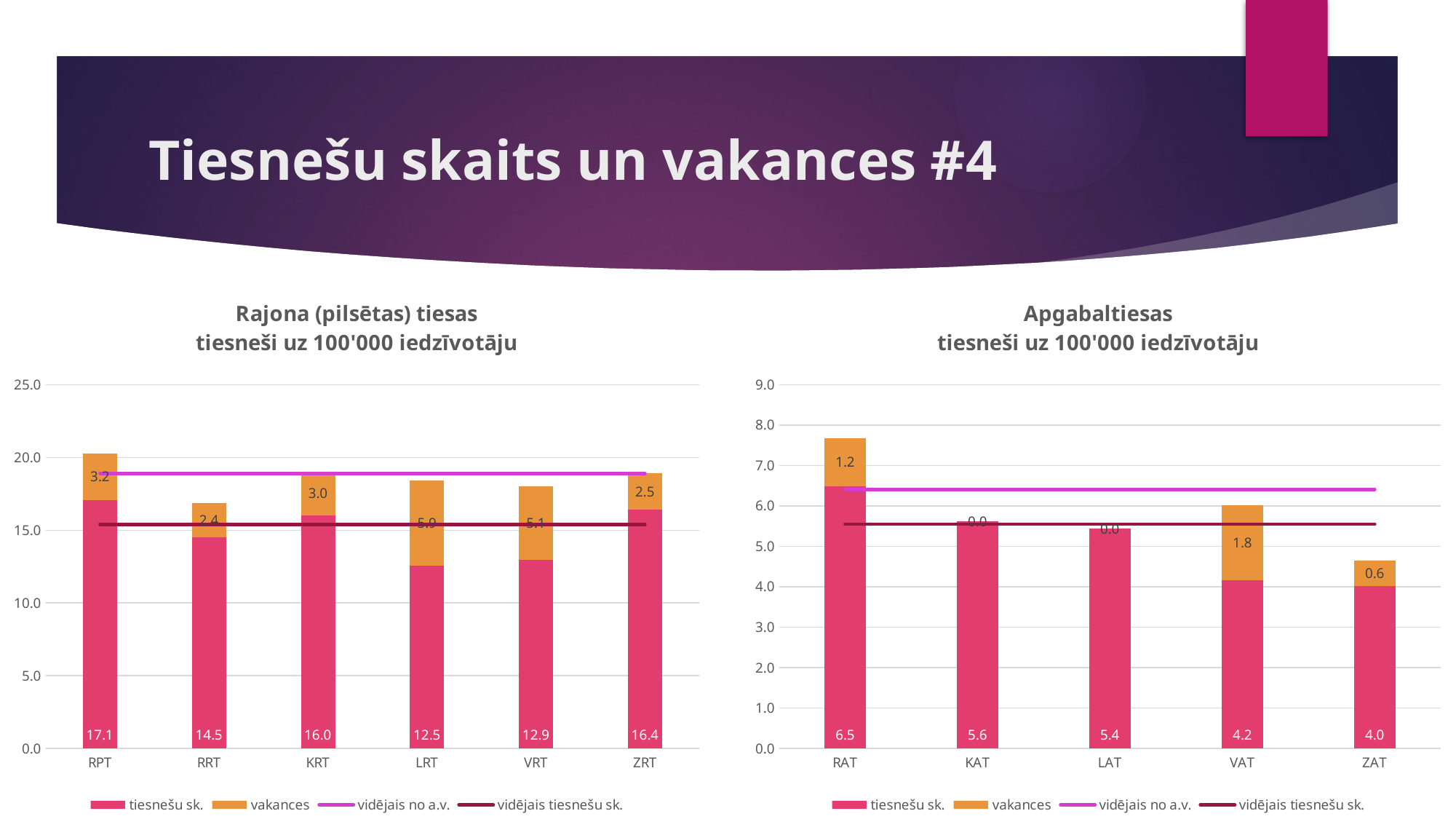
In the Rajona (pilsētas) tiesas chart, what is the total height of the stacked bar for RPT? 20.3 In the Apgabaltiesas chart, which category has the highest vakances value? VAT What kind of chart is the Apgabaltiesas chart? Stacked bar chart with lines In the Apgabaltiesas chart, how many entries does the legend list? 4 In the Rajona (pilsētas) tiesas chart, what is the vakances value for LRT? 5.9 In the Apgabaltiesas chart, what is the tiesnešu sk. value for KAT? 5.6 In the Apgabaltiesas chart, which is larger, the tiesnešu sk. value for RAT or for ZAT? RAT In the Apgabaltiesas chart, what is the total height of the stacked bar for RAT? 7.7 In the Rajona (pilsētas) tiesas chart, how many categories are shown on the x axis? 6 In the Rajona (pilsētas) tiesas chart, what is the tiesnešu sk. value for RPT? 17.1 In the Rajona (pilsētas) tiesas chart, what is the difference between the tiesnešu sk. values for RPT and RRT? 2.6 In the Rajona (pilsētas) tiesas chart, which category has the lowest tiesnešu sk. value? LRT